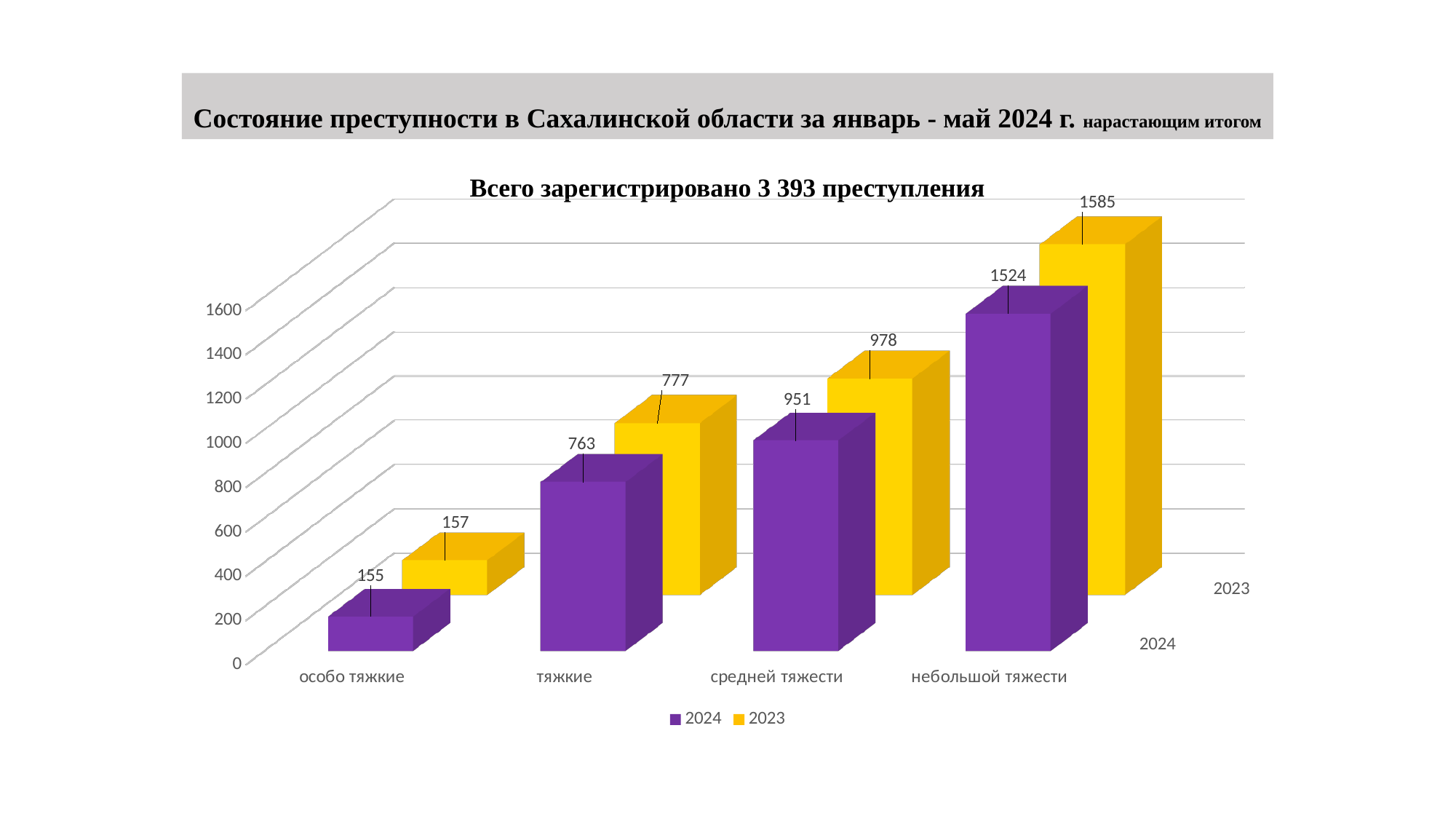
What is the difference between the 2023 and 2024 values for 'средней тяжести'? 27 What is the value for 'особо тяжкие' in the 2023 series? 157 What is the value for 'тяжкие' in the 2024 series? 763 What kind of chart is shown on the slide? bar chart What is the chart's title? Всего зарегистрировано 3 393 преступления Which category has the highest value in the 2024 series? небольшой тяжести Which is larger for 'небольшой тяжести': the 2024 value or the 2023 value? 2023 How many series does the legend list? 2 How many categories are shown on the x axis? 4 What is the value for 'небольшой тяжести' in the 2023 series? 1585 Which category has the lowest value in the 2023 series? особо тяжкие Do the 2024 values rise or fall from 'особо тяжкие' to 'небольшой тяжести'? rise